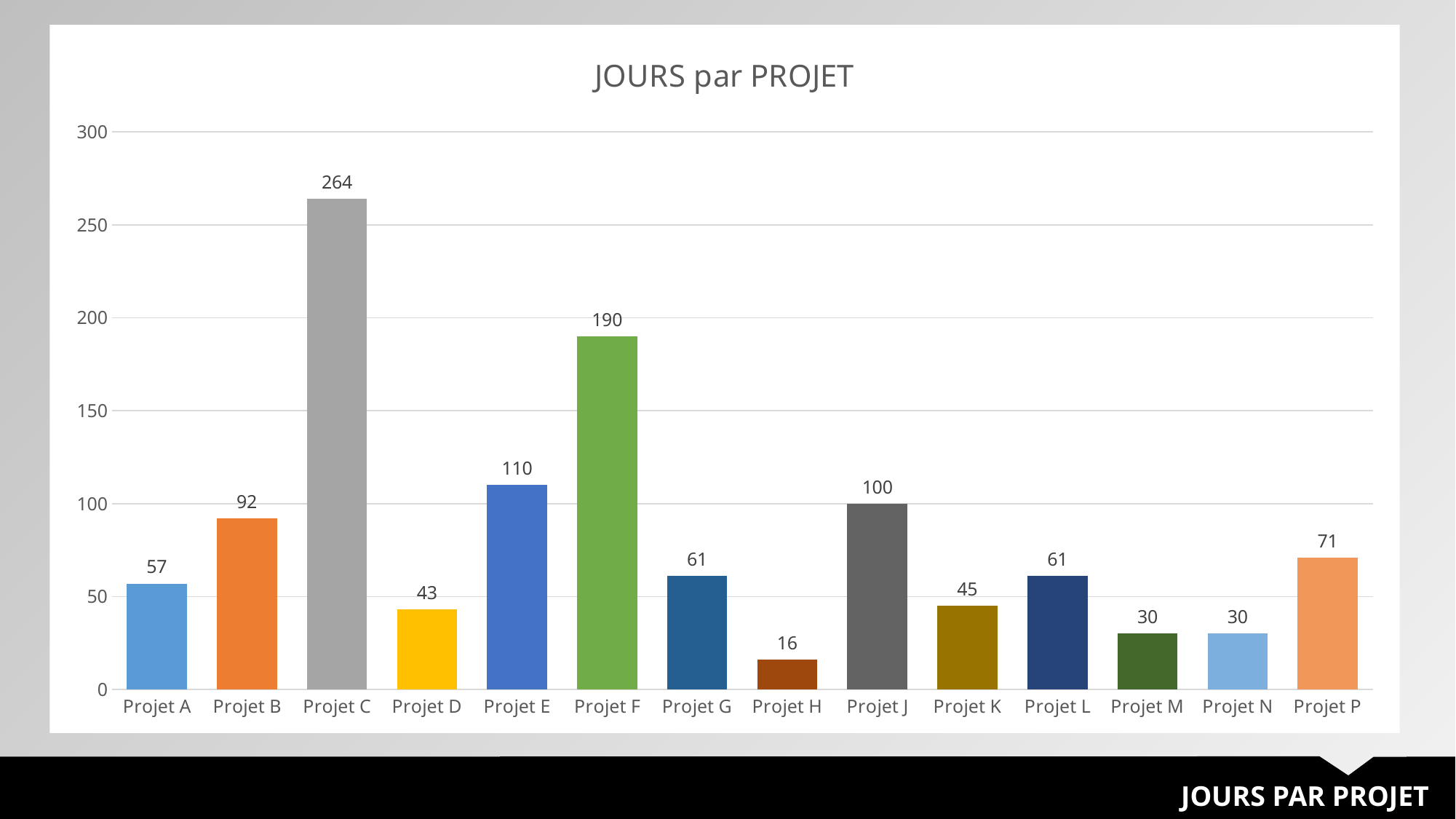
Which project has the highest value? Projet C How many projects are shown on the chart? 14 Which is larger, the value for Projet B or the value for Projet P? Projet B What is the title of the chart? JOURS par PROJET What is the difference between the values for Projet E and Projet D? 67 What is the value for Projet C? 264 What kind of chart is shown on the slide? bar chart What is the difference between the values for Projet C and Projet F? 74 Which project has the lowest value? Projet H What is the value for Projet J? 100 Is the value for Projet F greater or less than 150? greater What is the value for Projet H? 16